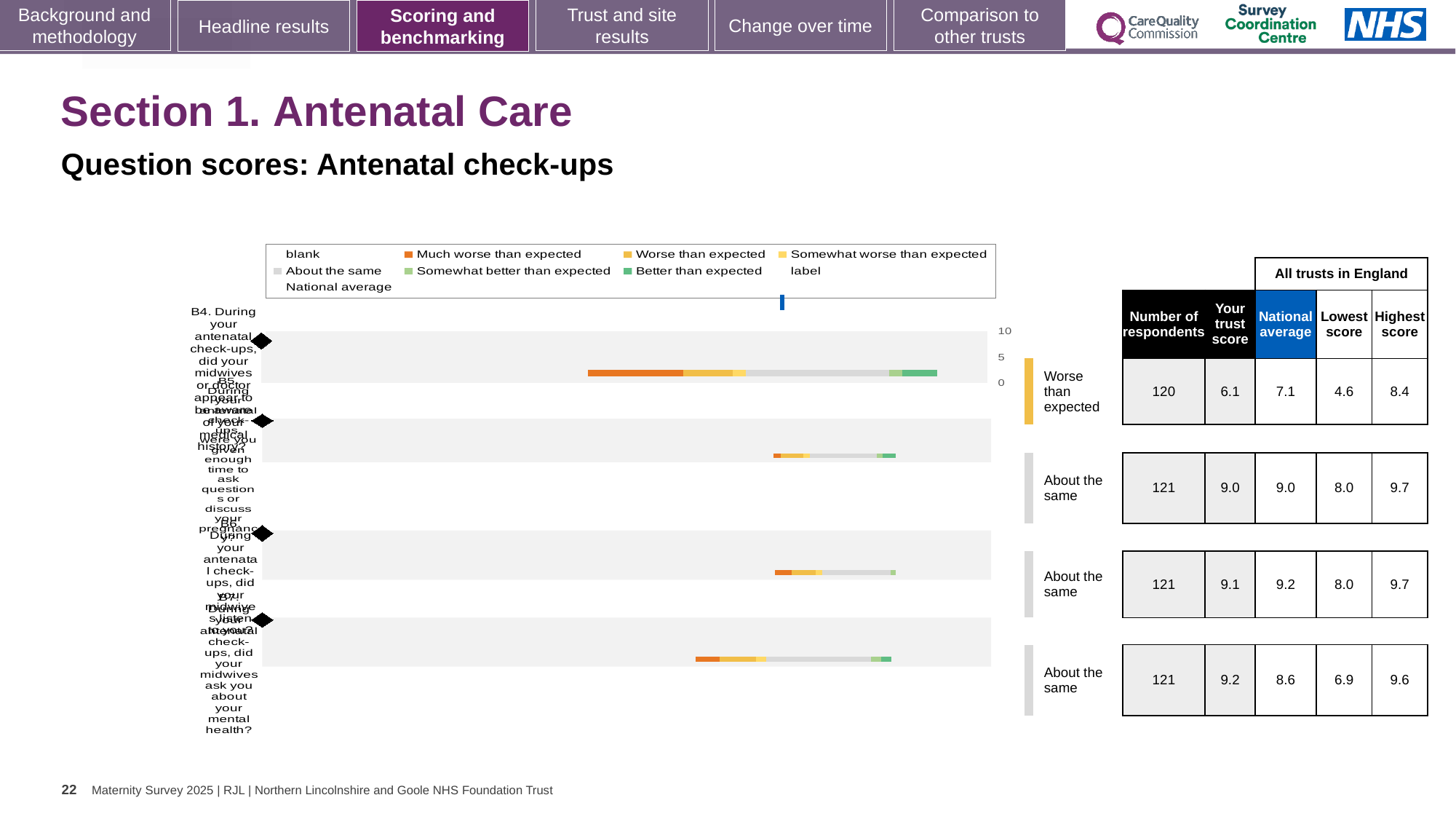
Which question has the lowest trust score in the table? B4 What kind of chart is shown on the slide? bar chart For B7, which is larger: the trust score or the national average? the trust score Which question is the first (top) bar in the chart? B4. During your antenatal check-ups, did your midwives or doctor appear to be aware of your medical history? In the table, what is the trust score for B4? 6.1 In the table, what is the highest score across all trusts in England for B5? 9.7 In the table, what is the national average for B7 (midwives asking about your mental health)? 8.6 Which question has the highest trust score in the table? B7 In the table, what is the number of respondents for B4? 120 What is the benchmark category shown next to the B4 bar? Worse than expected What is the difference between the national average and the trust score for B4? 1.0 How many questions (bars) are plotted in the chart? 4